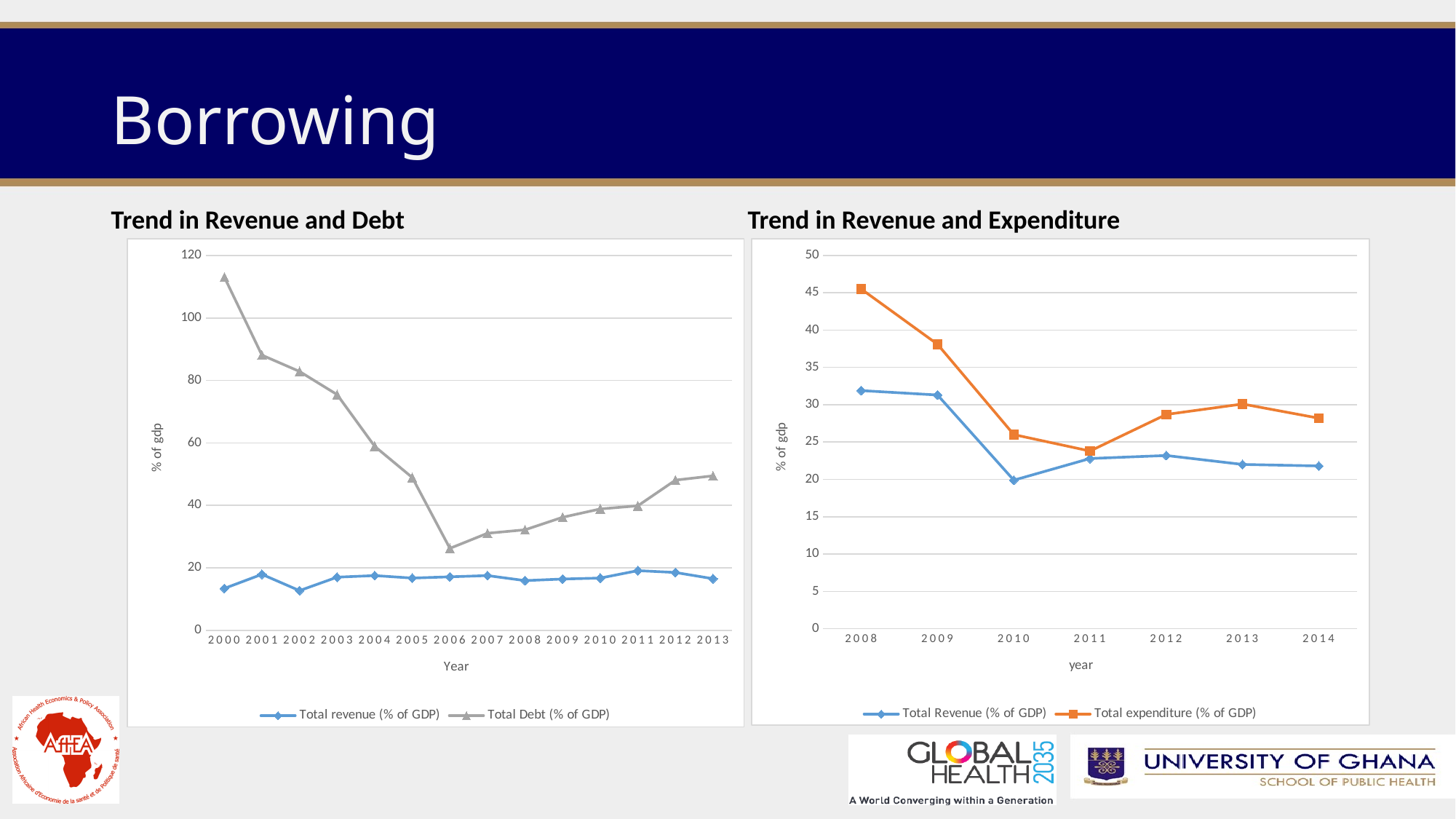
In the 'Trend in Revenue and Expenditure' chart, in which year is Total Revenue (% of GDP) lowest? 2010 In the 'Trend in Revenue and Debt' chart, does Total Debt (% of GDP) rise or fall from 2000 to 2006? fall In the 'Trend in Revenue and Debt' chart, in which year is Total Debt (% of GDP) highest? 2000 In the 'Trend in Revenue and Debt' chart, in which year is Total Debt (% of GDP) lowest? 2006 How many series does the legend of the 'Trend in Revenue and Expenditure' chart list? 2 What kind of chart is the 'Trend in Revenue and Debt' chart? line chart How many years are plotted on the x axis of the 'Trend in Revenue and Expenditure' chart? 7 In the 'Trend in Revenue and Expenditure' chart, is the Total expenditure (% of GDP) value for 2008 greater or less than 40? greater In the 'Trend in Revenue and Expenditure' chart, which series has the larger value in 2008, Total Revenue or Total expenditure? Total expenditure How many years are plotted on the x axis of the 'Trend in Revenue and Debt' chart? 14 What is the y-axis label of the 'Trend in Revenue and Expenditure' chart? % of gdp In the 'Trend in Revenue and Debt' chart, is the Total Debt (% of GDP) value for 2000 greater or less than 100? greater